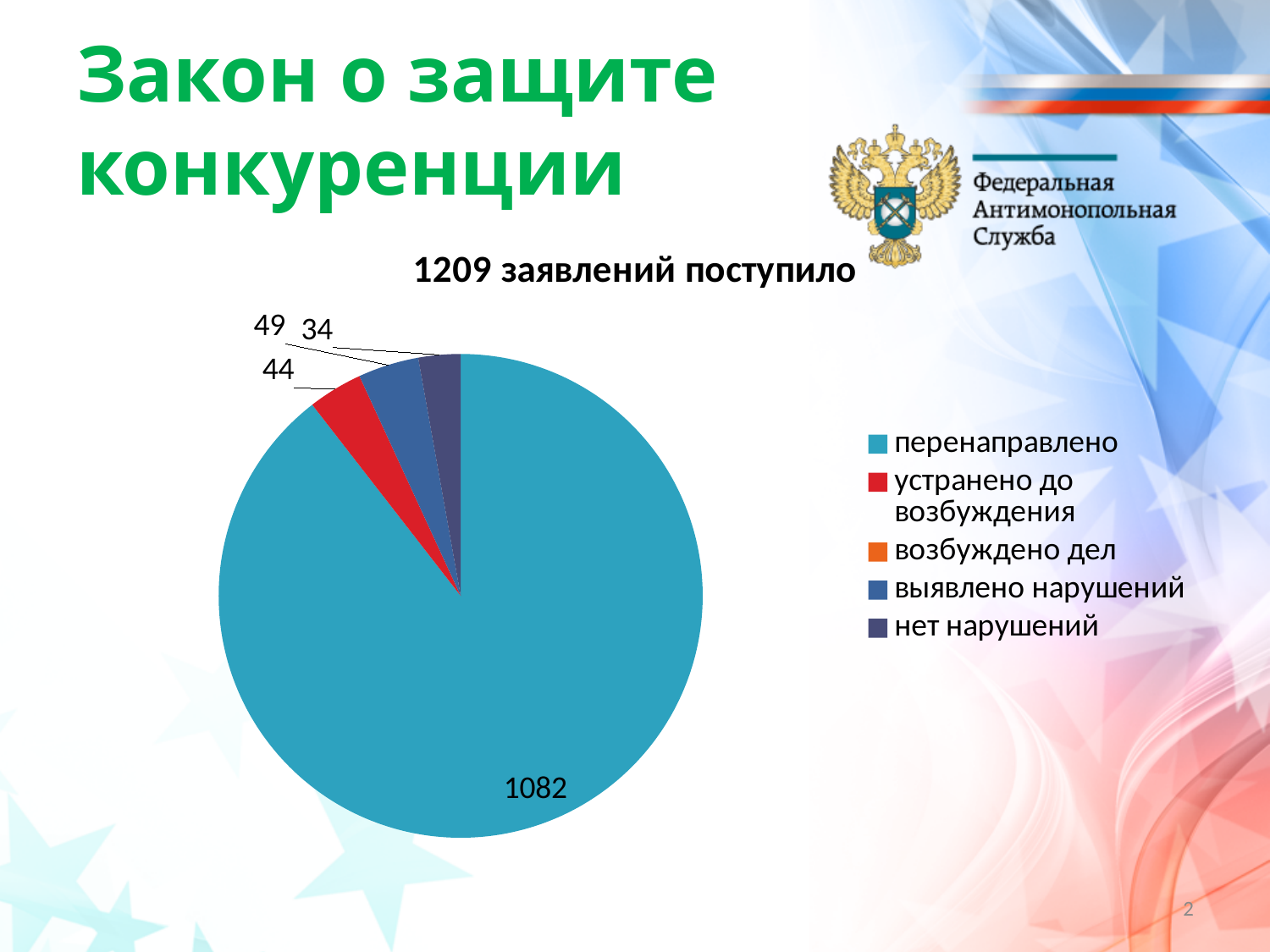
Which is larger: the slice for 'выявлено нарушений' or the slice for 'нет нарушений'? выявлено нарушений What is the smallest value printed on the pie chart? 34 What kind of chart is shown on the slide? pie chart Which category has the largest slice of the pie? перенаправлено How many entries does the legend of the pie chart list? 5 What is the value for the slice 'перенаправлено'? 1082 What is the title of the pie chart? 1209 заявлений поступило What is the value for the slice 'выявлено нарушений'? 49 What is the value for the slice 'нет нарушений'? 34 How many data labels are printed on the pie chart? 4 What is the value for the slice 'устранено до возбуждения'? 44 What is the difference between the values for 'перенаправлено' and 'устранено до возбуждения'? 1038